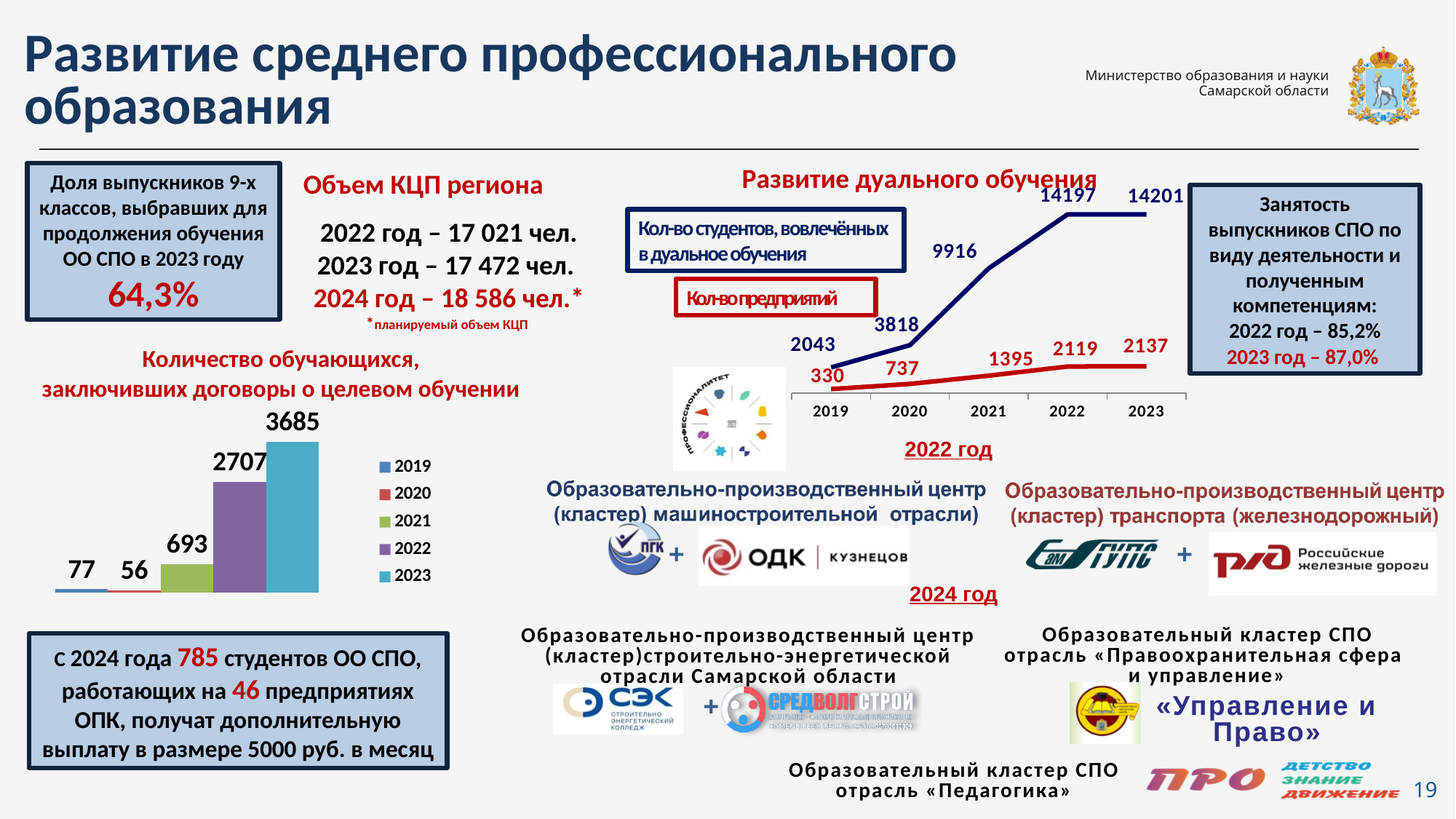
In the line chart 'Развитие дуального обучения', what is the difference between the number of enterprises in 2022 and in 2021? 724 In the bar chart 'Количество обучающихся, заключивших договоры о целевом обучении', what is the difference between the 2023 and 2022 values? 978 In the line chart 'Развитие дуального обучения', does the number of students involved in dual education rise or fall from 2019 to 2023? rise In the bar chart 'Количество обучающихся, заключивших договоры о целевом обучении', which is larger, the value for 2019 or for 2020? 2019 In the bar chart 'Количество обучающихся, заключивших договоры о целевом обучении', what is the value for 2023? 3685 In the line chart 'Развитие дуального обучения', which colour is the line for the number of enterprises (Кол-во предприятий)? red In the line chart 'Развитие дуального обучения', what is the number of enterprises (Кол-во предприятий) in 2023? 2137 In the line chart 'Развитие дуального обучения', how many years are shown on the x axis? 5 In the line chart 'Развитие дуального обучения', what is the number of students involved in dual education (Кол-во студентов) in 2021? 9916 What type of chart is 'Количество обучающихся, заключивших договоры о целевом обучении'? bar chart In the bar chart 'Количество обучающихся, заключивших договоры о целевом обучении', how many entries does the legend list? 5 In the bar chart 'Количество обучающихся, заключивших договоры о целевом обучении', which year has the lowest value? 2020